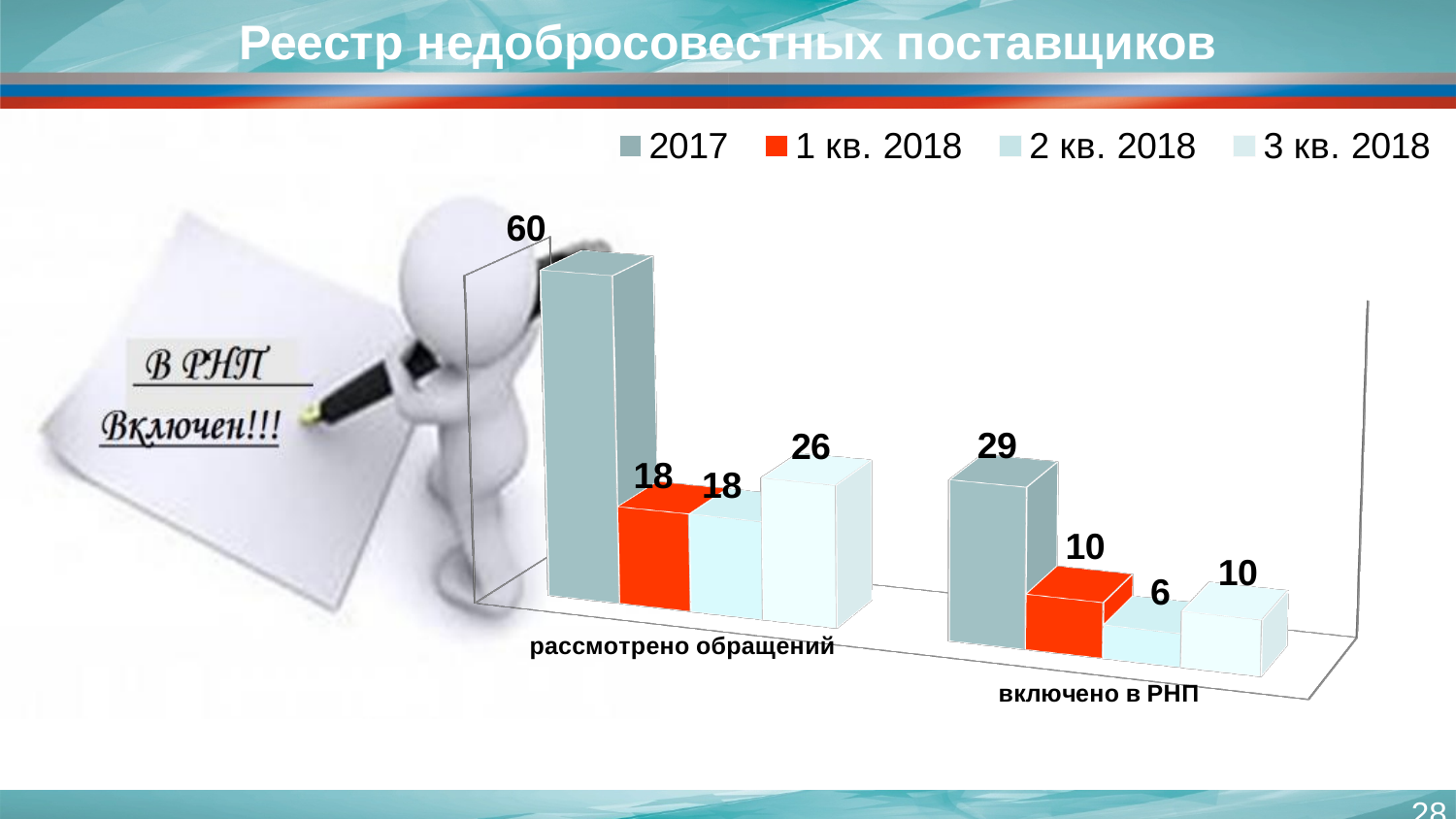
What type of chart is shown on the slide? bar chart What is the value for 3 кв. 2018 in the category "рассмотрено обращений"? 26 How many series does the legend list? 4 Which is larger in the category "включено в РНП": the value for 1 кв. 2018 or the value for 2 кв. 2018? 1 кв. 2018 What is the difference between the 2017 value and the 1 кв. 2018 value in the category "рассмотрено обращений"? 42 What is the value for 2017 in the category "рассмотрено обращений"? 60 Which series has the lowest value in the category "включено в РНП"? 2 кв. 2018 What is the value for 2017 in the category "включено в РНП"? 29 How many categories are shown on the x axis? 2 Which series has the highest value in the category "рассмотрено обращений"? 2017 What is the value for 2 кв. 2018 in the category "включено в РНП"? 6 What is the title of the slide containing the chart? Реестр недобросовестных поставщиков